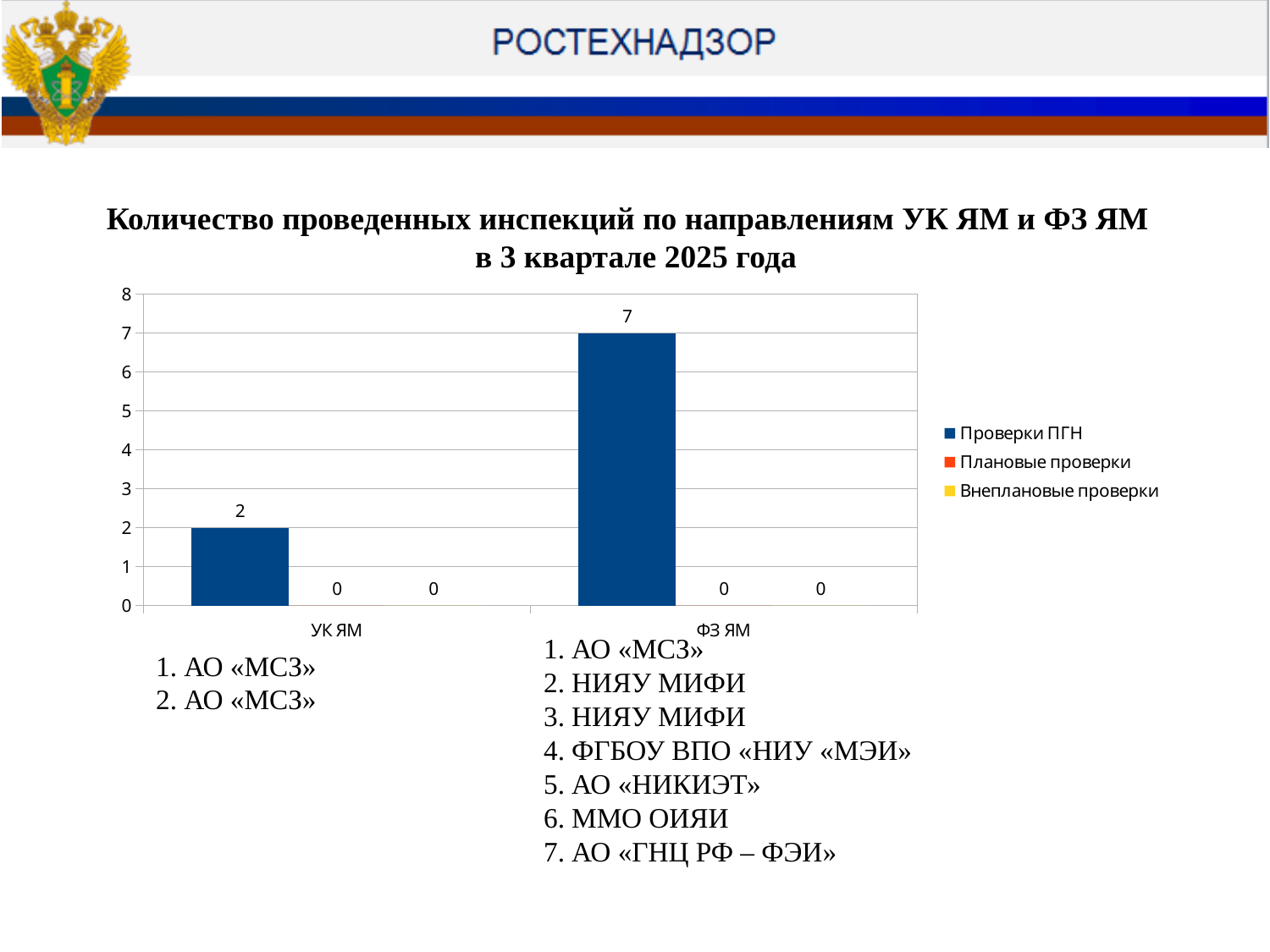
Is the Проверки ПГН value for ФЗ ЯМ larger or smaller than the Проверки ПГН value for УК ЯМ? larger What is the value of Плановые проверки for УК ЯМ? 0 What kind of chart is shown on the slide? bar chart How many series does the legend list? 3 What is the difference between the Проверки ПГН values for ФЗ ЯМ and УК ЯМ? 5 Which category has the higher value for Проверки ПГН? ФЗ ЯМ What is the title of the chart? Количество проведенных инспекций по направлениям УК ЯМ и ФЗ ЯМ в 3 квартале 2025 года Which category has the lower value for Проверки ПГН? УК ЯМ What is the value of Проверки ПГН for ФЗ ЯМ? 7 What is the value of Проверки ПГН for УК ЯМ? 2 What is the value of Внеплановые проверки for ФЗ ЯМ? 0 How many categories are shown on the x axis? 2